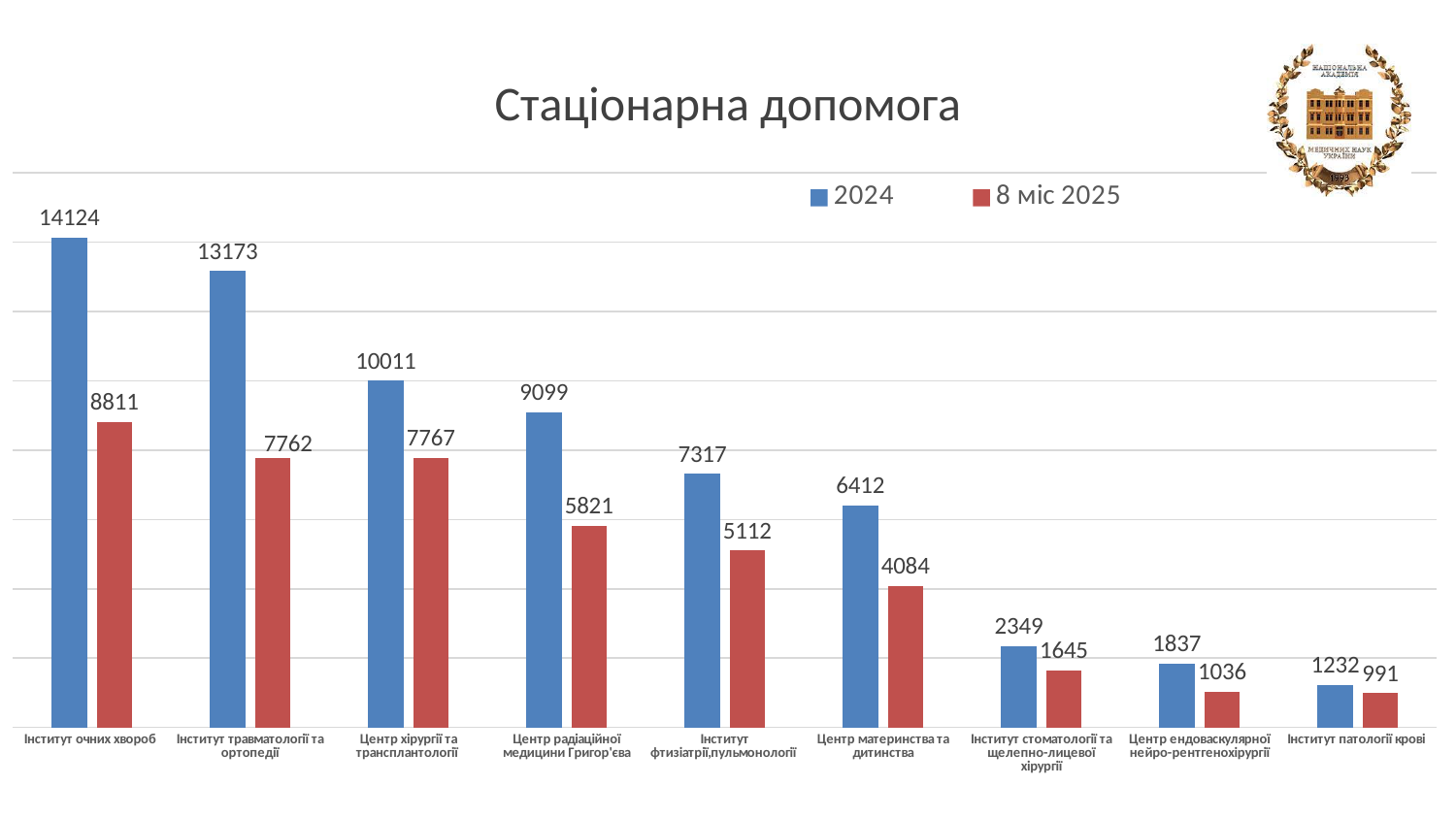
Which is larger: the 8 міс 2025 value for Центр хірургії та трансплантології or the 8 міс 2025 value for Інститут травматології та ортопедії? Центр хірургії та трансплантології What is the 2024 value for Центр материнства та дитинства? 6412 How many series does the legend list? 2 What kind of chart is shown on the slide? bar chart Which category has the highest 2024 value? Інститут очних хвороб What is the difference between the 2024 and 8 міс 2025 values for Інститут травматології та ортопедії? 5411 What is the 2024 value for Інститут очних хвороб? 14124 What is the 8 міс 2025 value for Центр радіаційної медицини Григор'єва? 5821 Which category has the lowest 8 міс 2025 value? Інститут патології крові How many categories are shown on the x axis? 9 What is the title of the chart? Стаціонарна допомога Do the 2024 values rise or fall from left to right along the x axis? fall